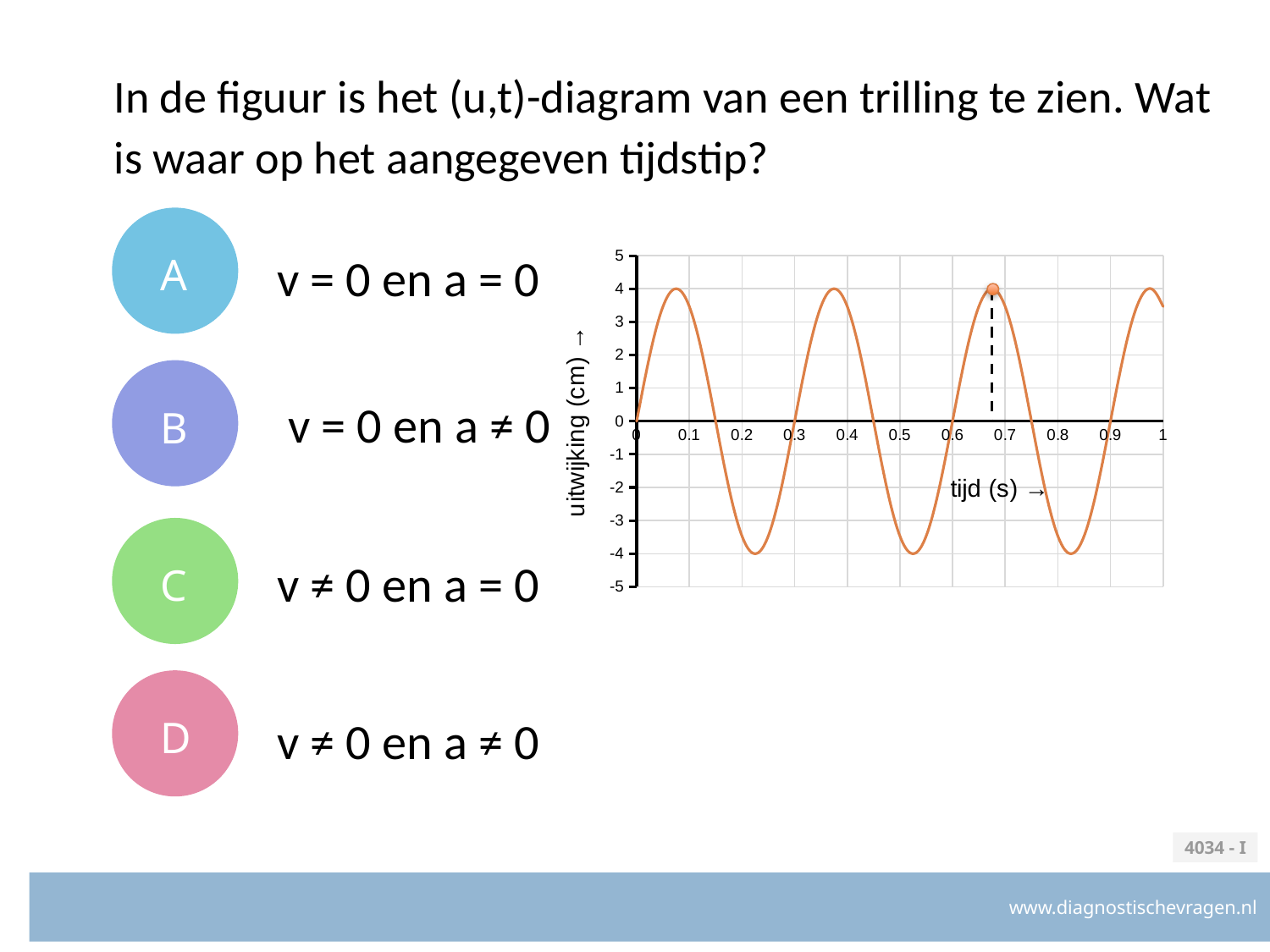
Is the value of the curve at time 0.5 greater or less than 0? less What is the value of the curve at time 0? 0 Is the time of the marked point greater or less than 0.6? greater Is the value of the curve at time 0.1 greater or less than 2? greater What is the label of the vertical axis of the chart? uitwijking (cm) What is the label of the horizontal axis of the chart? tijd (s) What kind of chart is shown on the slide? line chart How many peaks (maxima) does the curve show between time 0 and 1? 4